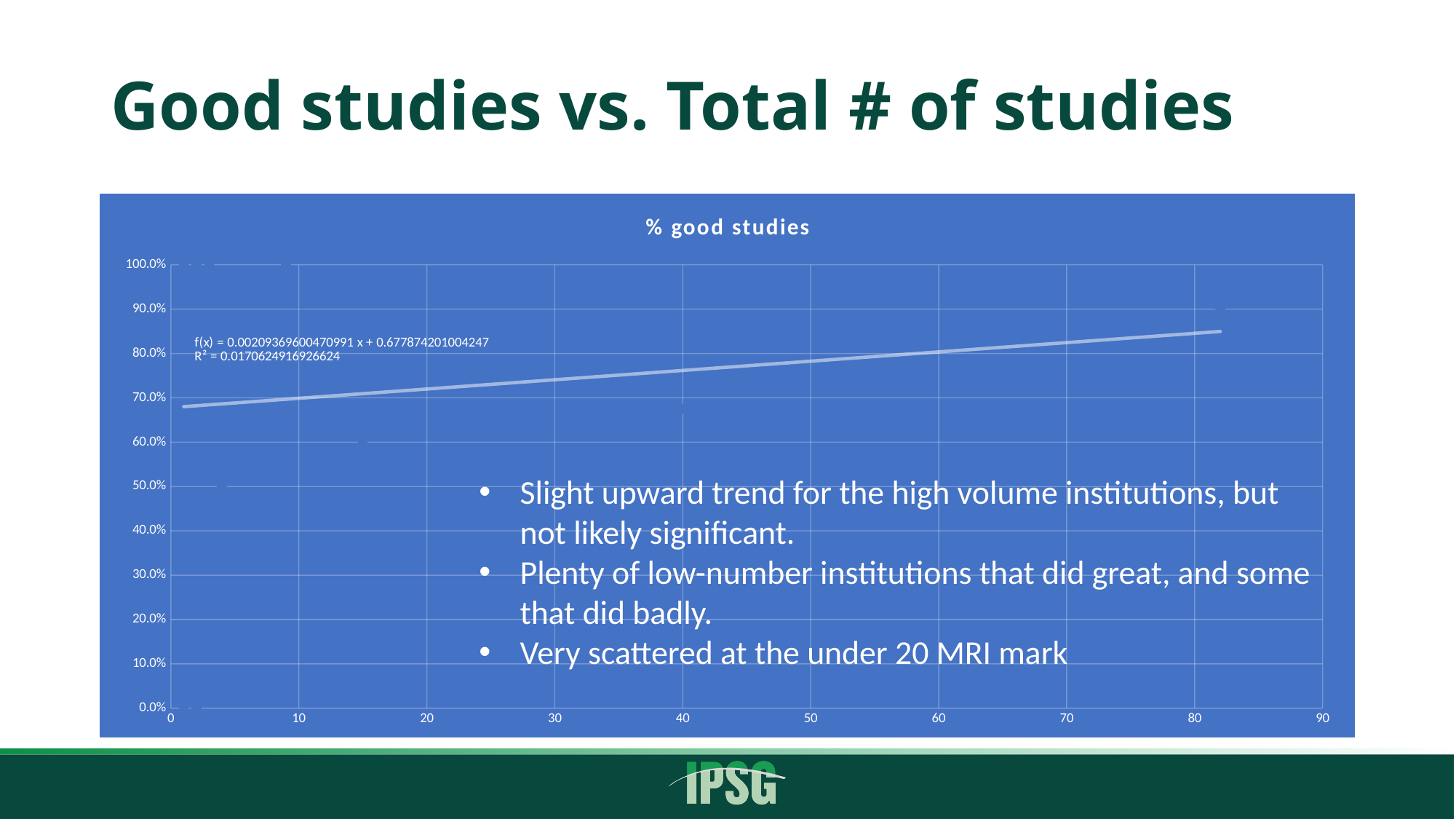
What kind of chart is shown on the slide? scatter chart What is the title of the chart? % good studies What is the highest value labelled on the x axis of the chart? 90 What R² value is printed on the chart for the trendline? R² = 0.0170624916926624 Does the trendline in the chart rise or fall as the x-axis value increases? rises What is the full trendline equation printed on the chart? f(x) = 0.00209369600470991 x + 0.677874201004247 Is the trendline value at x = 80 greater or less than 80.0%? greater What is the intercept of the trendline equation printed on the chart? 0.677874201004247 Is the trendline value at x = 0 greater or less than 70.0%? less What is the slope of the trendline equation printed on the chart? 0.00209369600470991 How many tick labels are shown on the x axis of the chart? 10